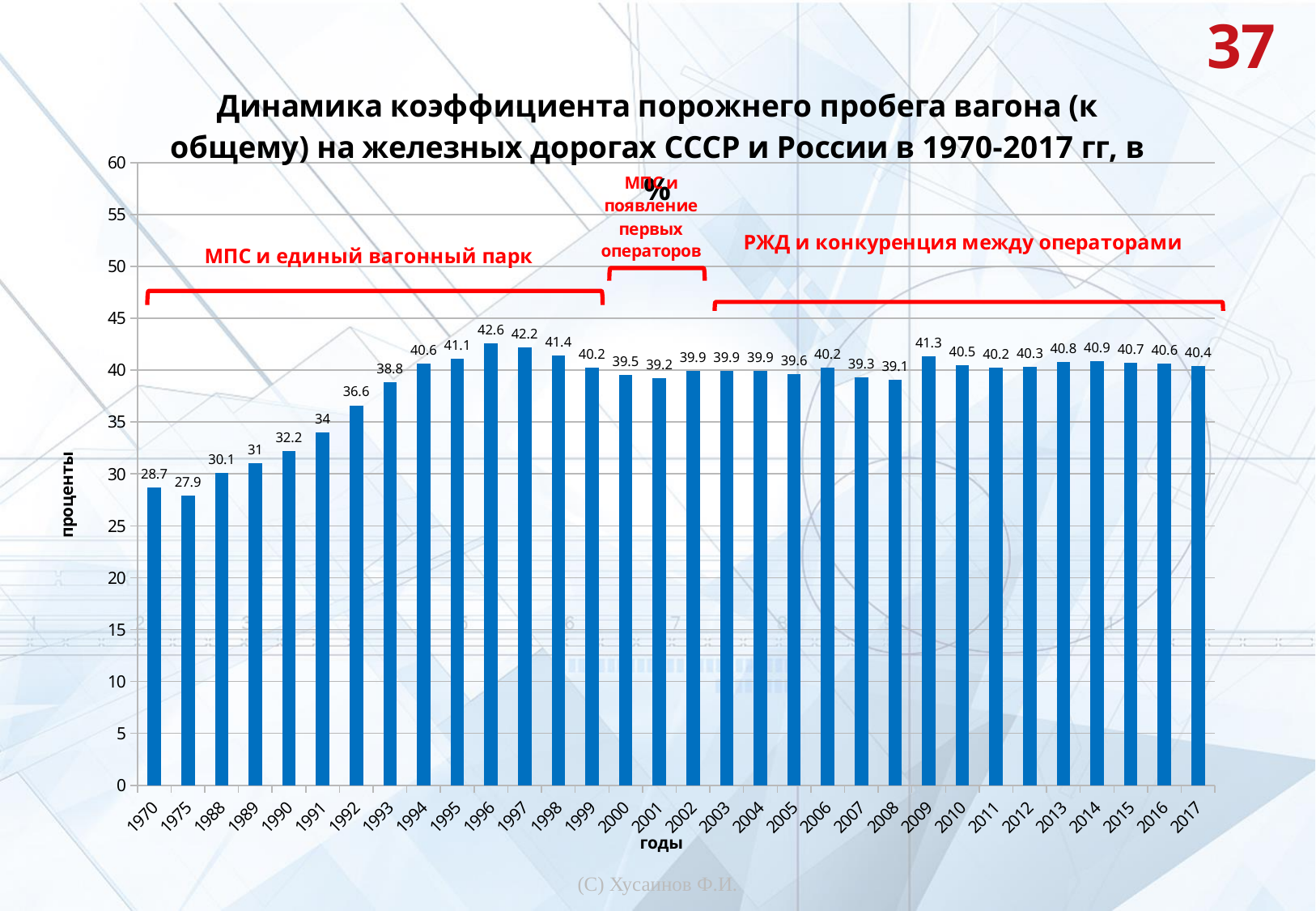
What is the value for 1975? 27.9 What is the difference between the values for 1996 and 1975? 14.7 What kind of chart is this? bar chart Is the value for 1993 greater or less than 40? less How many years are shown on the x axis? 32 Which is larger, the value for 1992 or the value for 2008? 2008 Which year has the lowest value? 1975 What is the value for 2009? 41.3 What is the difference between the values for 2017 and 1970? 11.7 What is the value for 1996? 42.6 What is the value for 2017? 40.4 Which year has the highest value? 1996